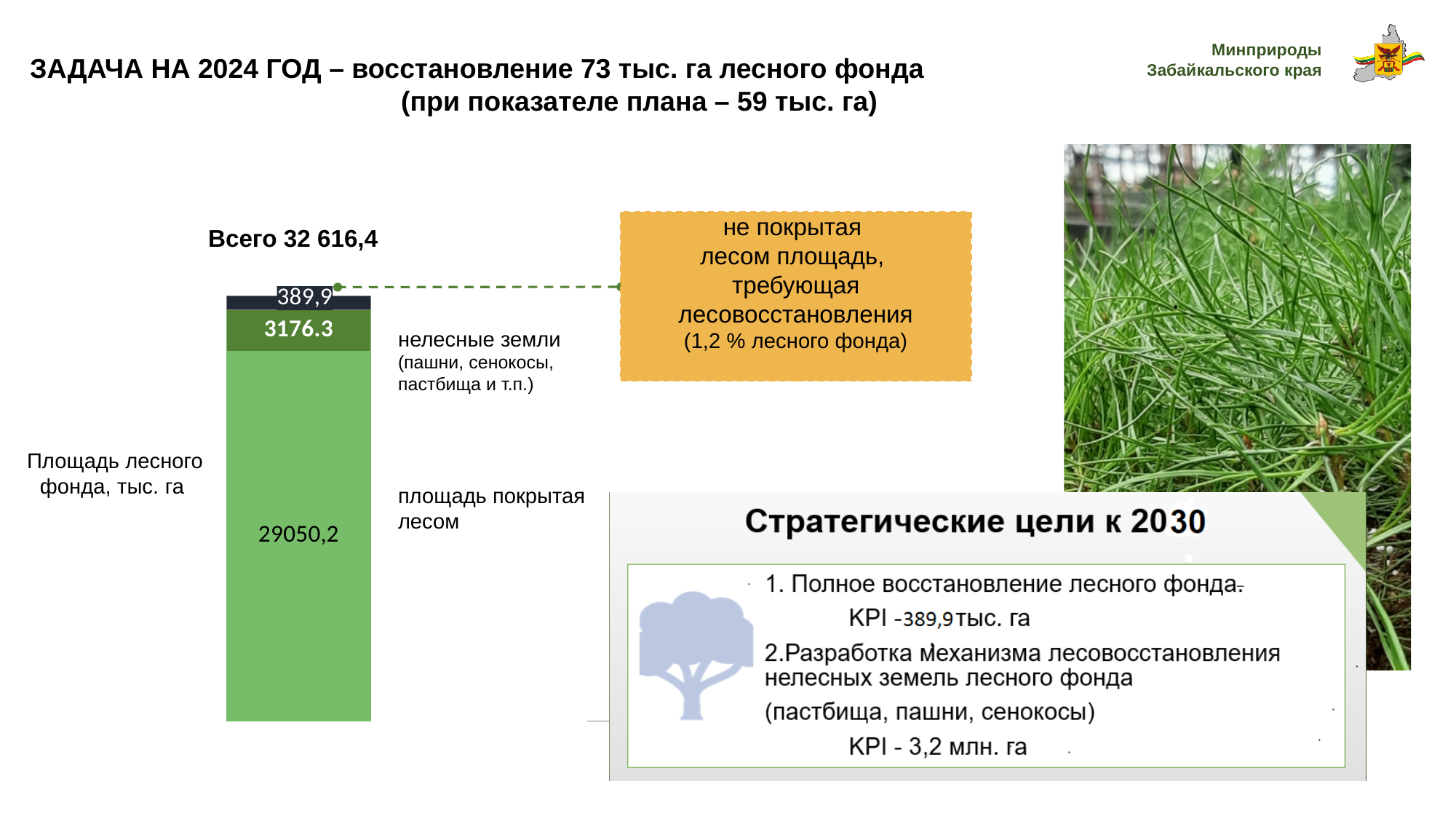
What is the value of the segment for 'не покрытая лесом площадь, требующая лесовосстановления'? 389,9 How many segments make up the stacked bar? 3 What is the value of the segment labelled 'нелесные земли (пашни, сенокосы, пастбища и т.п.)'? 3176.3 What share of the forest fund does the area not covered by forest and requiring reforestation represent, as stated on the slide? 1,2 % Which is larger: the 'нелесные земли' segment or the 'не покрытая лесом площадь' segment? нелесные земли Which segment of the stacked bar is the largest? площадь покрытая лесом What is the total of the stacked bar ('Всего')? 32 616,4 What colour is the largest segment of the stacked bar? Green What is the value of the segment labelled 'площадь покрытая лесом'? 29050,2 What kind of chart is shown on the slide? Stacked bar chart What unit is the forest fund area measured in, according to the axis label? тыс. га Which segment of the stacked bar is the smallest? не покрытая лесом площадь, требующая лесовосстановления